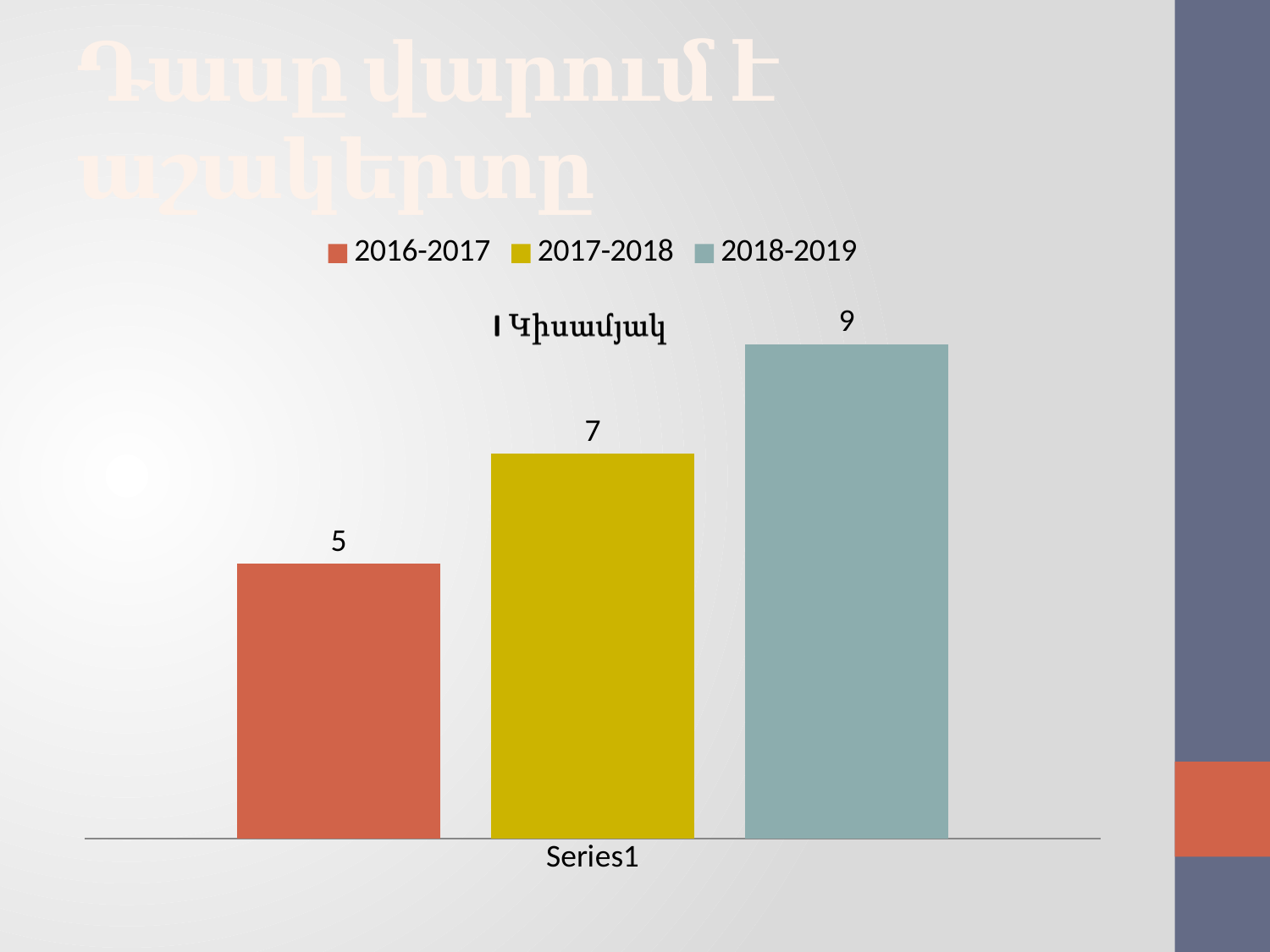
How many series does the legend list? 3 What kind of chart is shown on the slide? Bar chart What is the difference between the values for 2018-2019 and 2016-2017? 4 Which series has the lowest value? 2016-2017 Which is larger, the value for 2017-2018 or the value for 2018-2019? 2018-2019 What is the title of the chart? I Կիսամյակ What is the value for 2018-2019? 9 What is the value for 2017-2018? 7 Which series has the highest value? 2018-2019 What is the value for 2016-2017? 5 What is the difference between the values for 2017-2018 and 2016-2017? 2 How many bars are plotted in the chart? 3